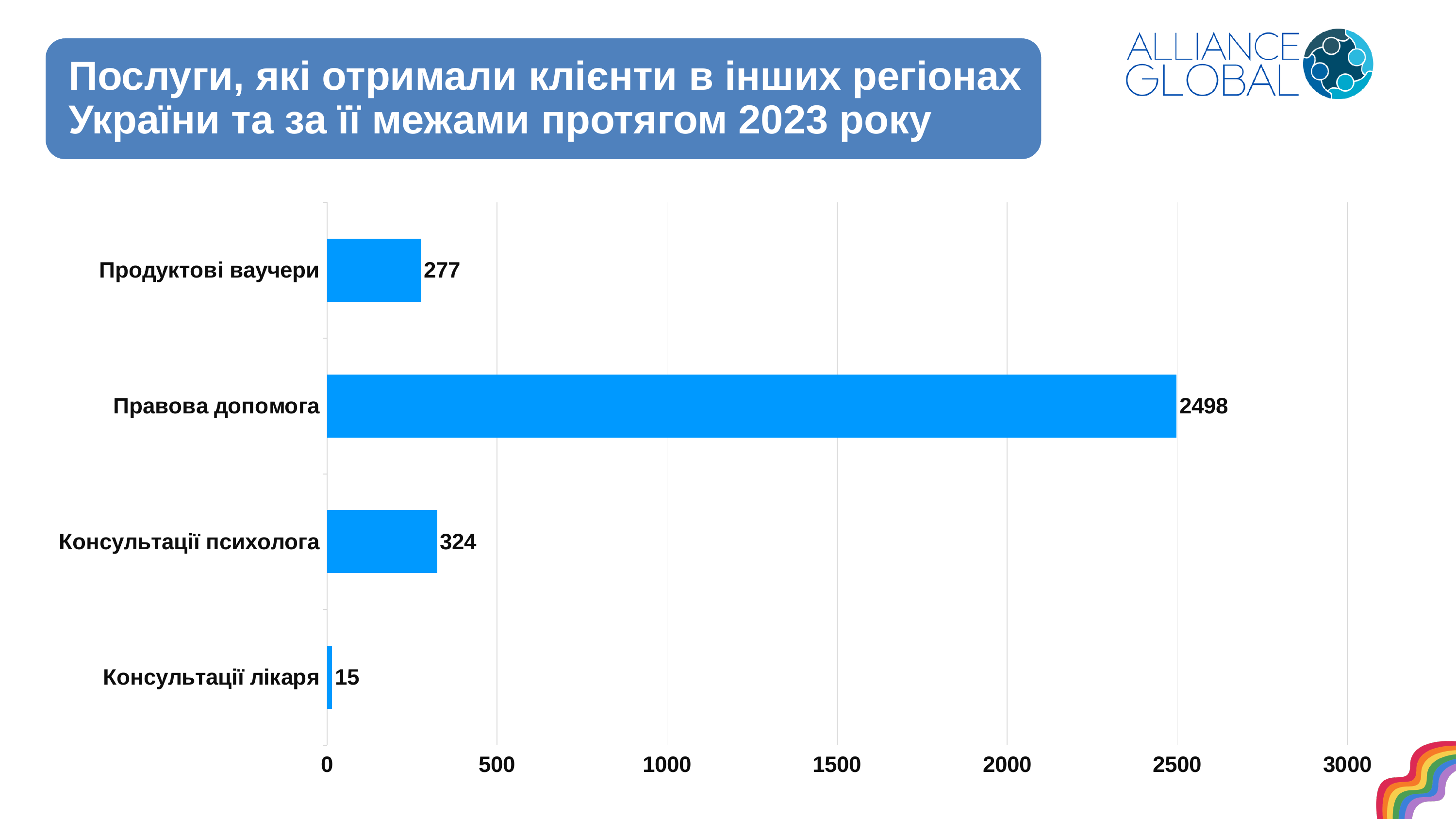
What kind of chart is shown on the slide? bar chart What is the value for Продуктові ваучери? 277 Which category has the highest value? Правова допомога Which category has the lowest value? Консультації лікаря Which is larger, the value for Консультації психолога or the value for Продуктові ваучери? Консультації психолога How many categories are shown in the chart? 4 What is the difference between the values for Консультації психолога and Продуктові ваучери? 47 What is the value for Правова допомога? 2498 What is the value for Консультації лікаря? 15 What is the difference between the values for Правова допомога and Консультації психолога? 2174 Is the value for Правова допомога greater or less than 2000? greater What is the value for Консультації психолога? 324